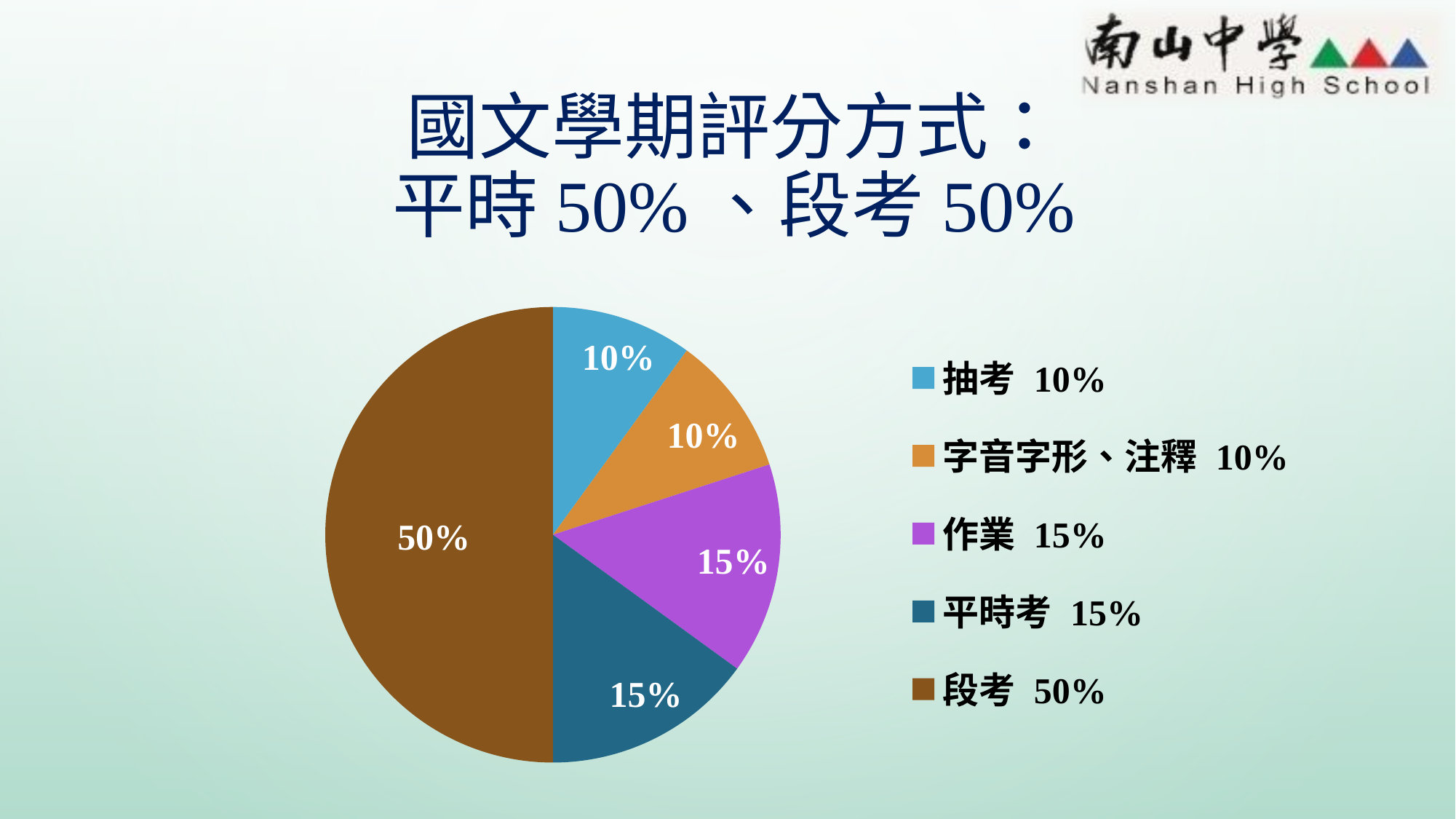
What kind of chart is shown on the slide? pie chart Which category has the largest slice of the pie? 段考 What percentage does the 平時考 slice represent? 15% What colour is the 段考 slice in the pie chart? brown What percentage does the 抽考 slice represent? 10% How many slices does the pie chart have? 5 What is the difference between the 段考 share and the 作業 share? 35% What percentage does the 作業 slice represent? 15% What percentage does the 段考 slice represent? 50% Which is larger, the 段考 slice or the 平時考 slice? 段考 How many entries does the legend list? 5 What percentage does the 字音字形、注釋 slice represent? 10%